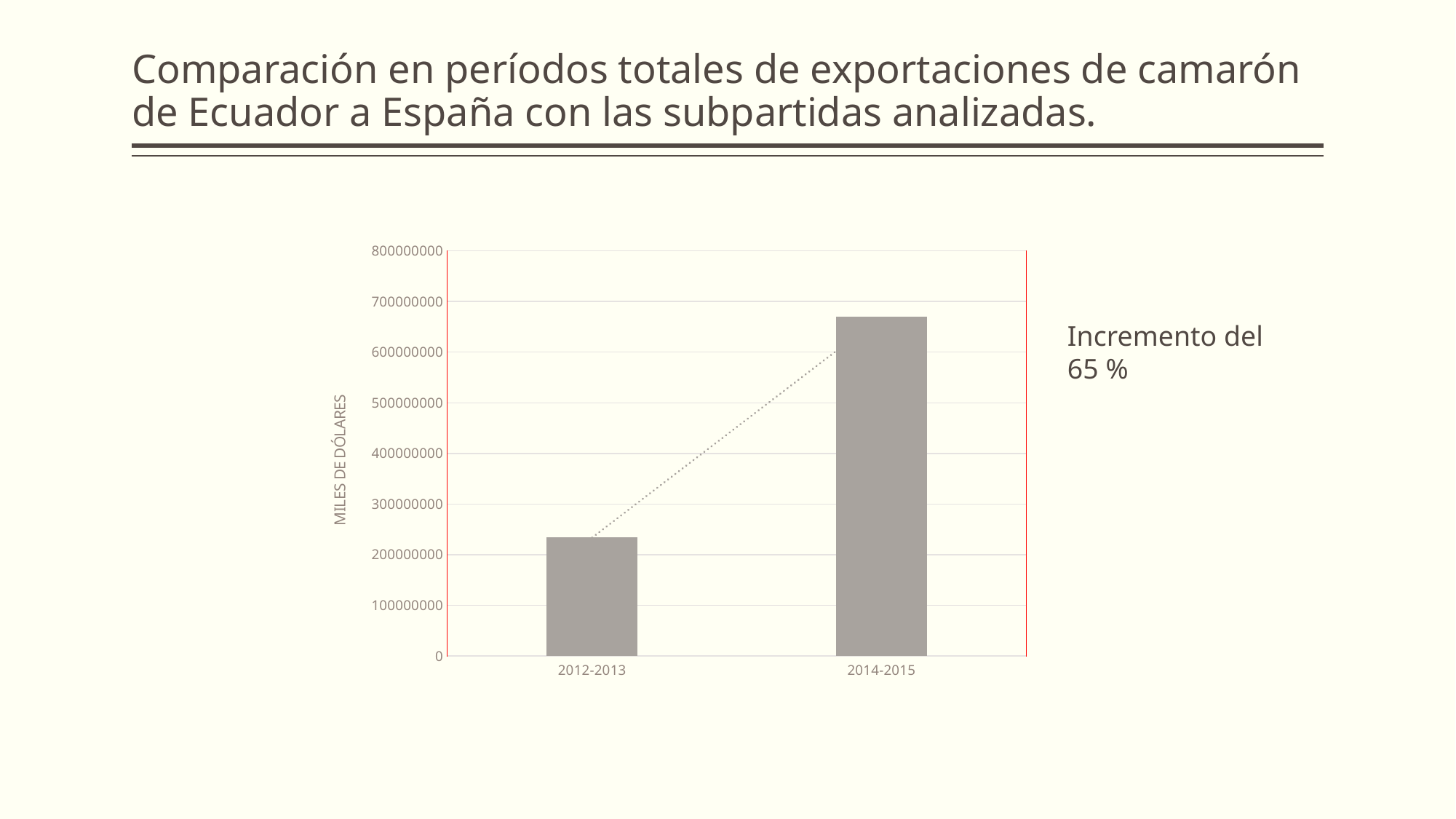
Which period has the lowest value? 2012-2013 Is the value for 2012-2013 greater or less than 200000000? greater Is the value for 2014-2015 greater or less than 600000000? greater What kind of chart is shown on the slide? bar chart How many categories are plotted on the x axis? 2 Do the values rise or fall from 2012-2013 to 2014-2015? rise Which period has the highest value? 2014-2015 What percentage increase is stated next to the chart? 65 % Is the value for 2012-2013 greater or less than 300000000? less Which period has the higher value, 2012-2013 or 2014-2015? 2014-2015 What is the label of the vertical axis? MILES DE DÓLARES